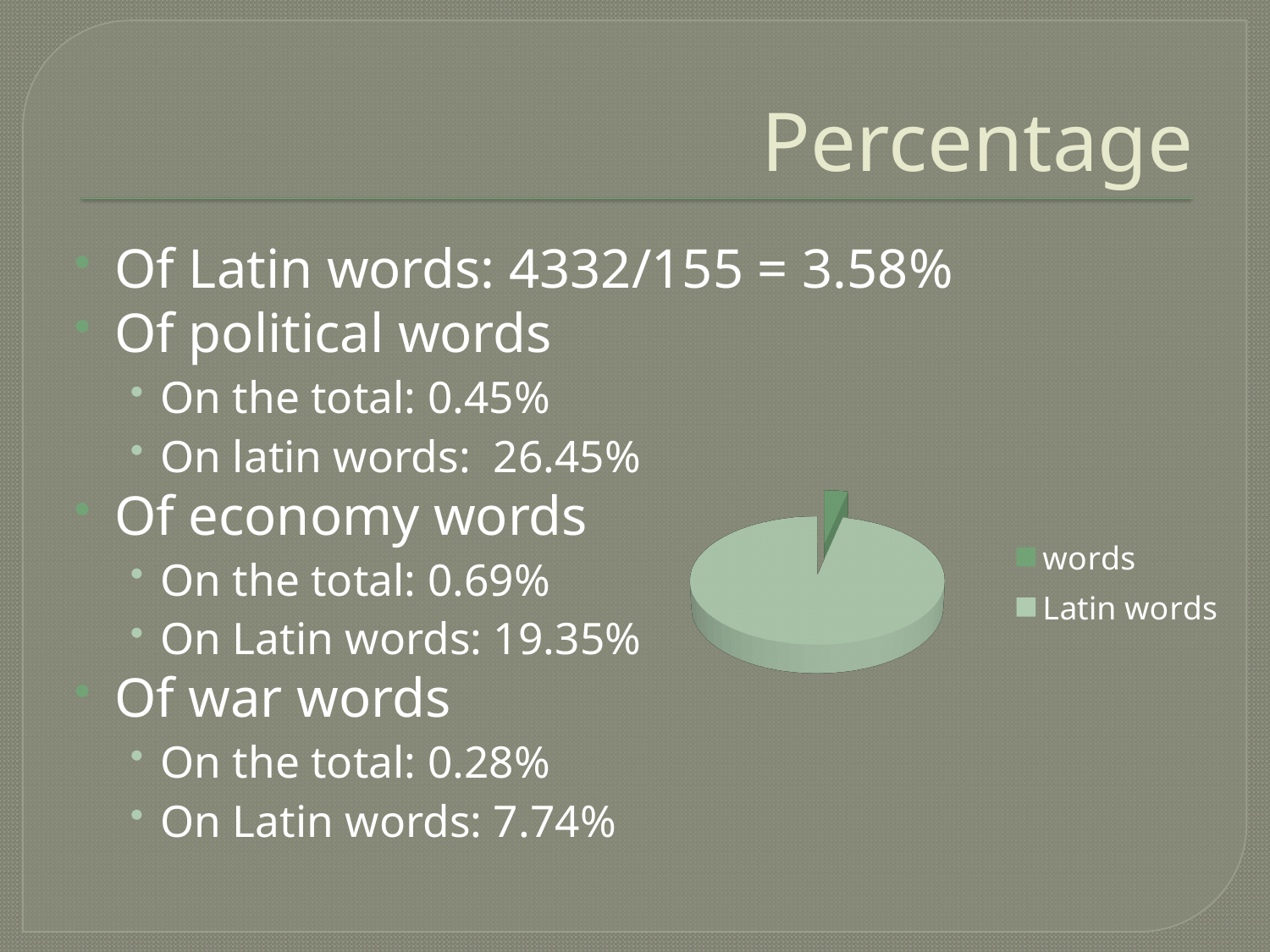
Which slice of the pie chart is the largest? Latin words Does the "Latin words" slice take up more or less than half of the pie chart? more What are the two legend entries of the pie chart? words, Latin words Which slice of the pie chart is the smallest? words What kind of chart is shown on the slide? Pie chart Which legend entry of the pie chart is shown in the darker green colour? words How many entries does the legend of the pie chart list? 2 How many slices does the pie chart have? 2 Does the "words" slice take up more or less than half of the pie chart? less In the pie chart, which slice is larger: "words" or "Latin words"? Latin words